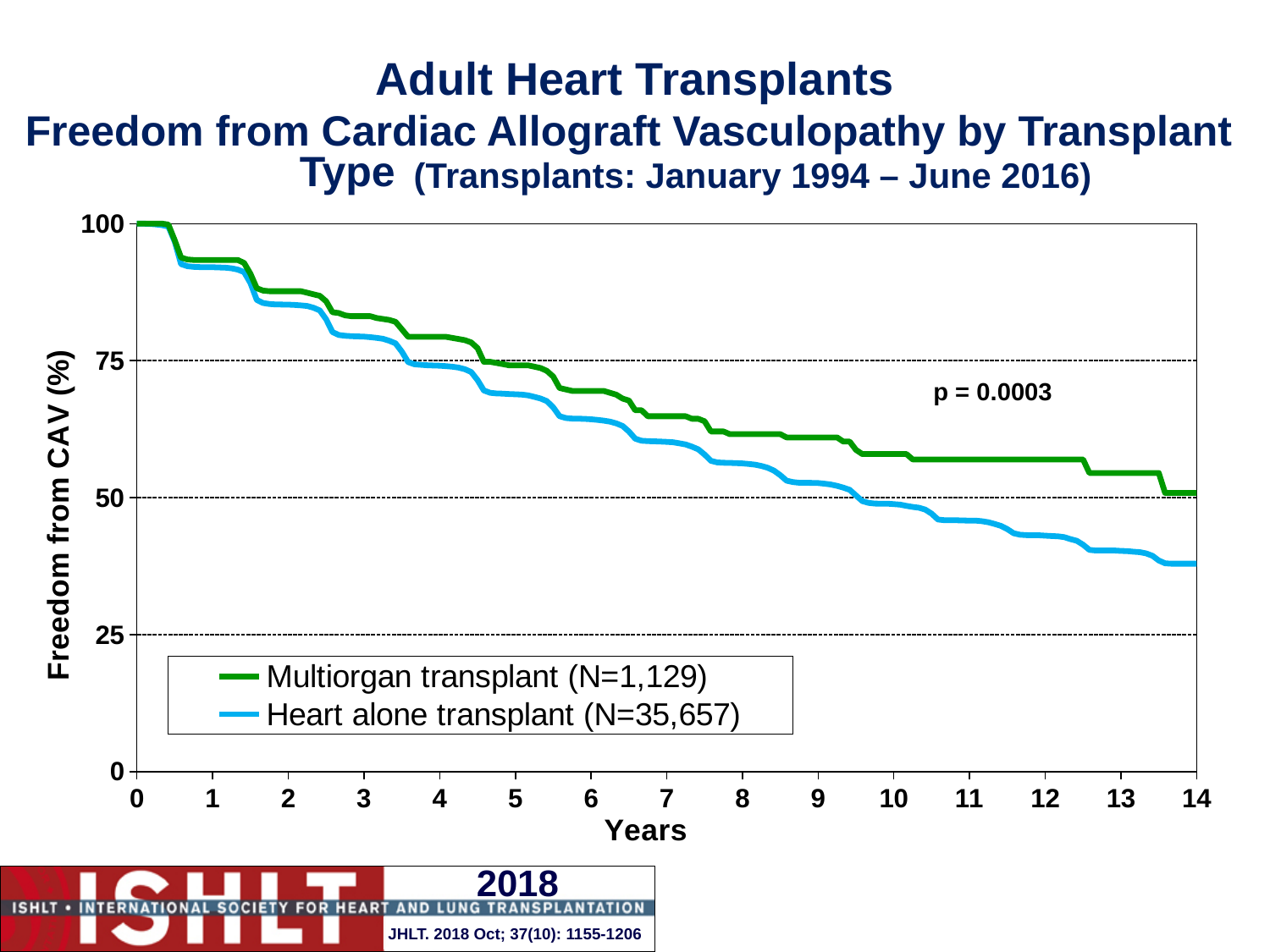
Which series has the higher freedom from CAV at 14 years, Multiorgan transplant or Heart alone transplant? Multiorgan transplant What is the freedom from CAV (%) for both series at year 0? 100 What p-value is shown on the chart? p = 0.0003 What kind of chart is shown on the slide? Line chart Is the value for Heart alone transplant at 5 years greater or less than 75? less Is the value for Heart alone transplant at 7 years greater or less than 50? greater Is the value for Heart alone transplant at 14 years greater or less than 50? less Do the freedom from CAV values rise or fall as years increase? Fall How many series does the legend list? 2 What is the N for the Heart alone transplant series in the legend? N=35,657